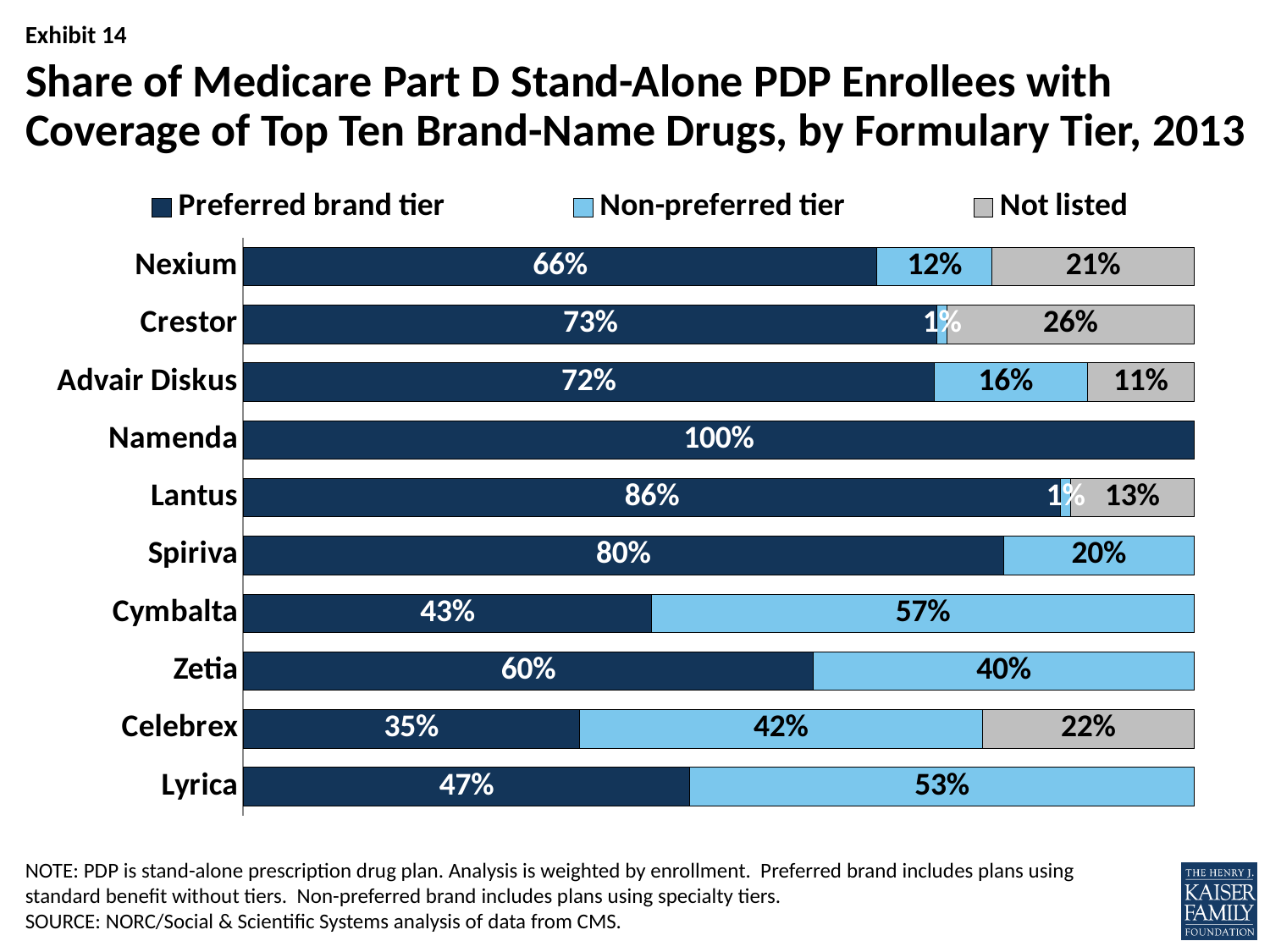
What share of enrollees have Cymbalta covered on the non-preferred tier? 57% What share of enrollees have Nexium covered on the preferred brand tier? 66% Which has a larger non-preferred tier share, Advair Diskus or Spiriva? Spiriva What kind of chart is shown on the slide? Stacked bar chart What is the total of the Crestor bar across all three tiers? 100% How many series does the legend list? 3 Which drug has the highest preferred brand tier share? Namenda What is the difference between the preferred brand tier shares for Lantus and Zetia? 26 percentage points How many drugs are shown in the chart? 10 What share of enrollees have Celebrex not listed on the formulary? 22% Which drug has the lowest preferred brand tier share? Celebrex Which legend entry is shown in grey? Not listed